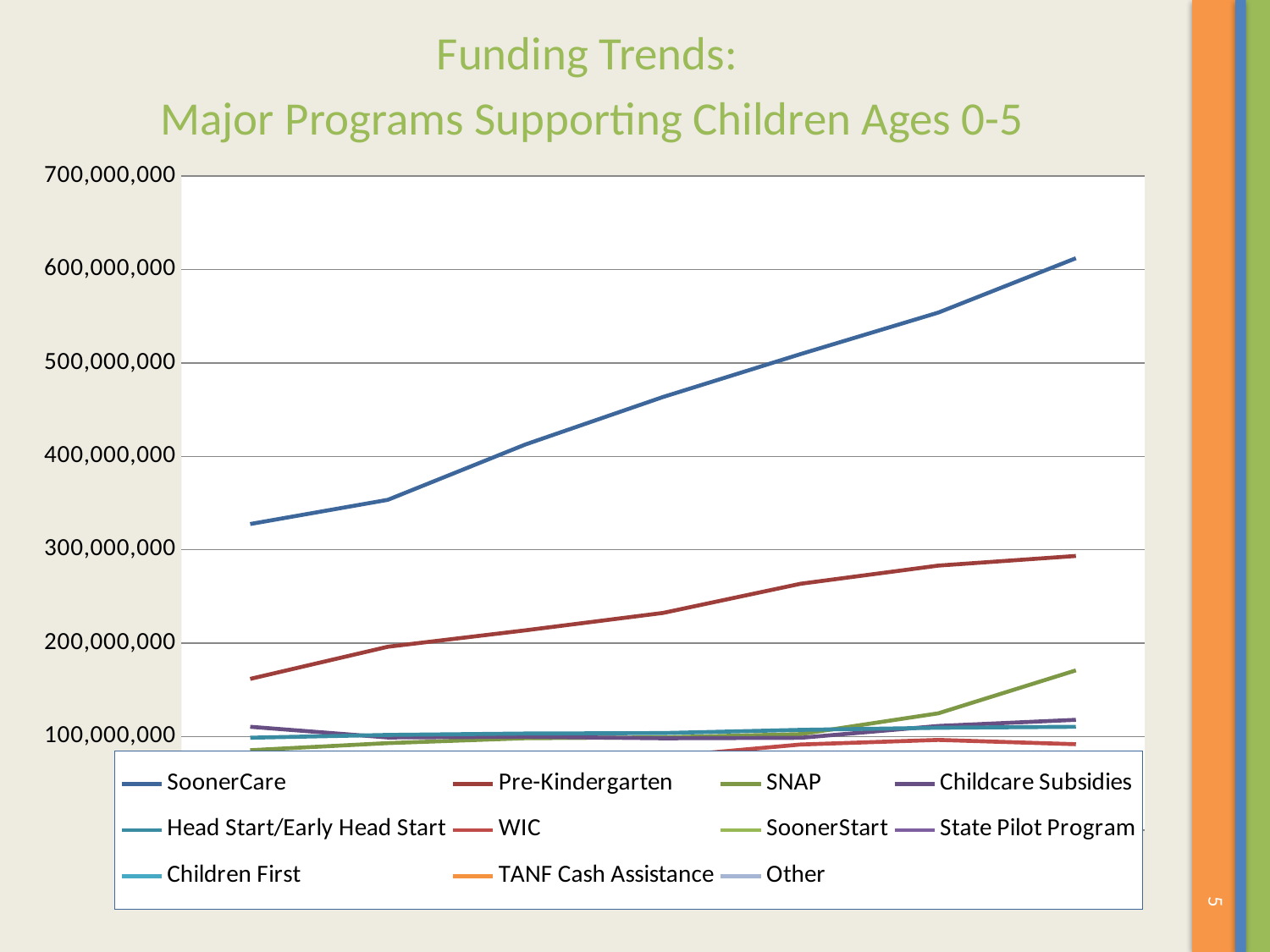
What colour is the SoonerCare line in the legend? blue Does the SoonerCare line rise or fall along the x axis? rises At the right end of the chart, which is larger: SoonerCare or Pre-Kindergarten? SoonerCare What is the title of the chart? Funding Trends: Major Programs Supporting Children Ages 0-5 Which series has the highest funding values throughout the chart? SoonerCare Is the last value of the SoonerCare line greater or less than 500,000,000? greater Which series has the second-highest line on the chart? Pre-Kindergarten Is the first value of the SoonerCare line greater or less than 400,000,000? less What kind of chart is shown on the slide? line chart Does the Pre-Kindergarten line rise or fall along the x axis? rises Is the first value of the Pre-Kindergarten line greater or less than 200,000,000? less How many series does the legend list? 11